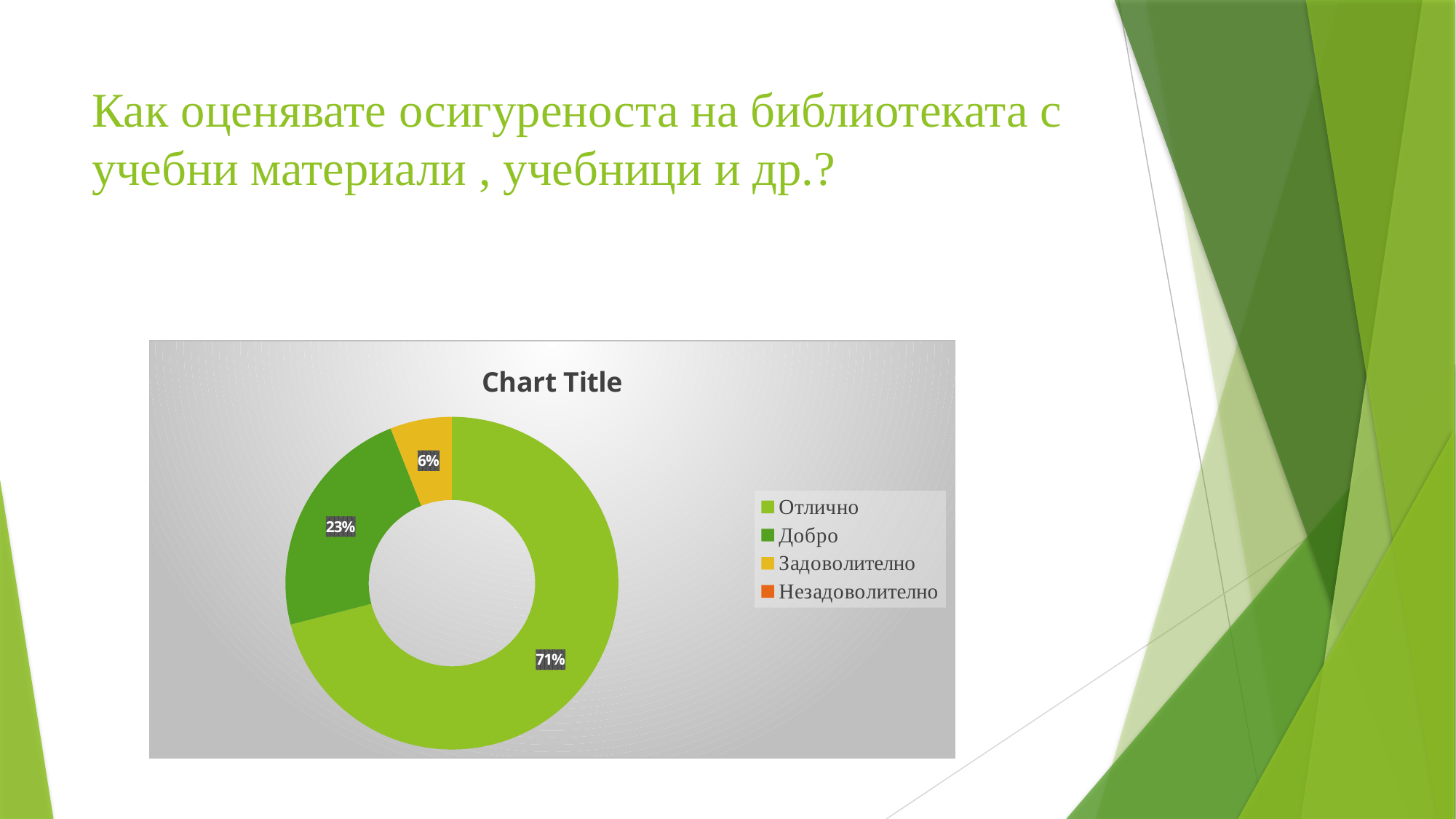
What is the difference in percentage points between the Отлично and Добро shares? 48% Which legend entry is shown in orange? Незадоволително What is the title shown on the chart? Chart Title Which category has the largest share in the doughnut chart? Отлично What is the difference in percentage points between the Добро and Задоволително shares? 17% What share of the doughnut chart is labelled Задоволително? 6% What kind of chart is shown on the slide? Doughnut chart Which share is larger, Добро or Задоволително? Добро Which of the labelled slices has the smallest share in the doughnut chart? Задоволително How many entries does the legend of the chart list? 4 What share of the doughnut chart is labelled Добро? 23% What share of the doughnut chart is labelled Отлично? 71%